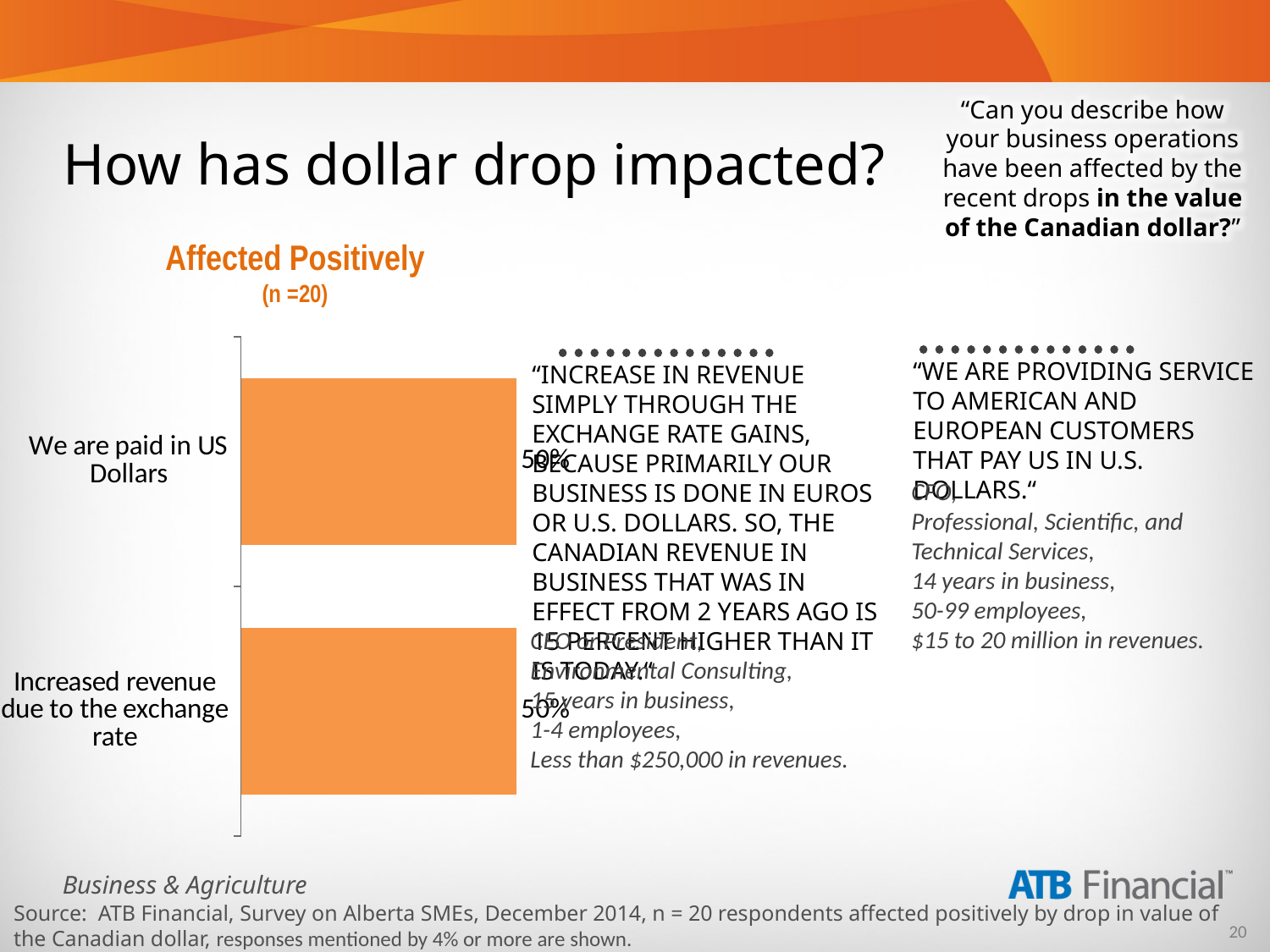
How many categories are shown in the Affected Positively chart? 2 What is the value for "We are paid in US Dollars" in the Affected Positively chart? 50% What is the title of the chart on the slide? Affected Positively Do the two categories in the Affected Positively chart have the same value? Yes What kind of chart is the Affected Positively chart? bar chart Are the bars in the Affected Positively chart oriented horizontally or vertically? horizontally What sample size (n) is shown under the chart title? n =20 What is the value for "Increased revenue due to the exchange rate" in the Affected Positively chart? 50%